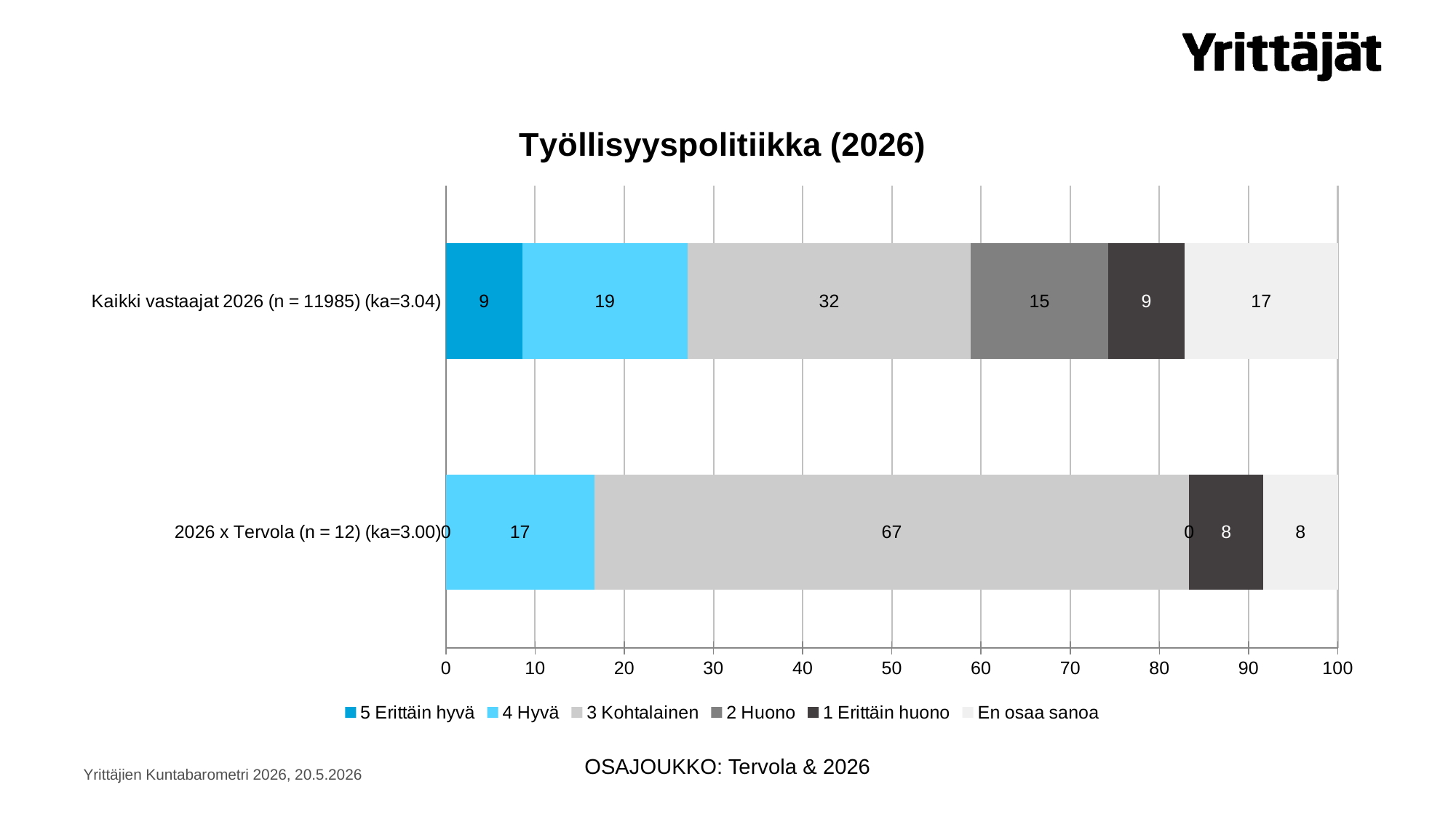
Which category has the larger "En osaa sanoa" value, "Kaikki vastaajat 2026 (n = 11985) (ka=3.04)" or "2026 x Tervola (n = 12) (ka=3.00)"? Kaikki vastaajat 2026 (n = 11985) (ka=3.04) What kind of chart is shown on the slide? Stacked bar chart What is the value of "4 Hyvä" for "2026 x Tervola (n = 12) (ka=3.00)"? 17 Which segment is the largest in the "2026 x Tervola (n = 12) (ka=3.00)" bar? 3 Kohtalainen What is the value of "2 Huono" for "Kaikki vastaajat 2026 (n = 11985) (ka=3.04)"? 15 What is the total of the "Kaikki vastaajat 2026 (n = 11985) (ka=3.04)" bar? 101 What is the difference between the "3 Kohtalainen" values for "2026 x Tervola (n = 12) (ka=3.00)" and "Kaikki vastaajat 2026 (n = 11985) (ka=3.04)"? 35 What is the value of "1 Erittäin huono" for "2026 x Tervola (n = 12) (ka=3.00)"? 8 How many categories (bars) are shown in the chart? 2 How many series does the legend list? 6 What is the value of "3 Kohtalainen" for "Kaikki vastaajat 2026 (n = 11985) (ka=3.04)"? 32 What is the title of the chart? Työllisyyspolitiikka (2026)